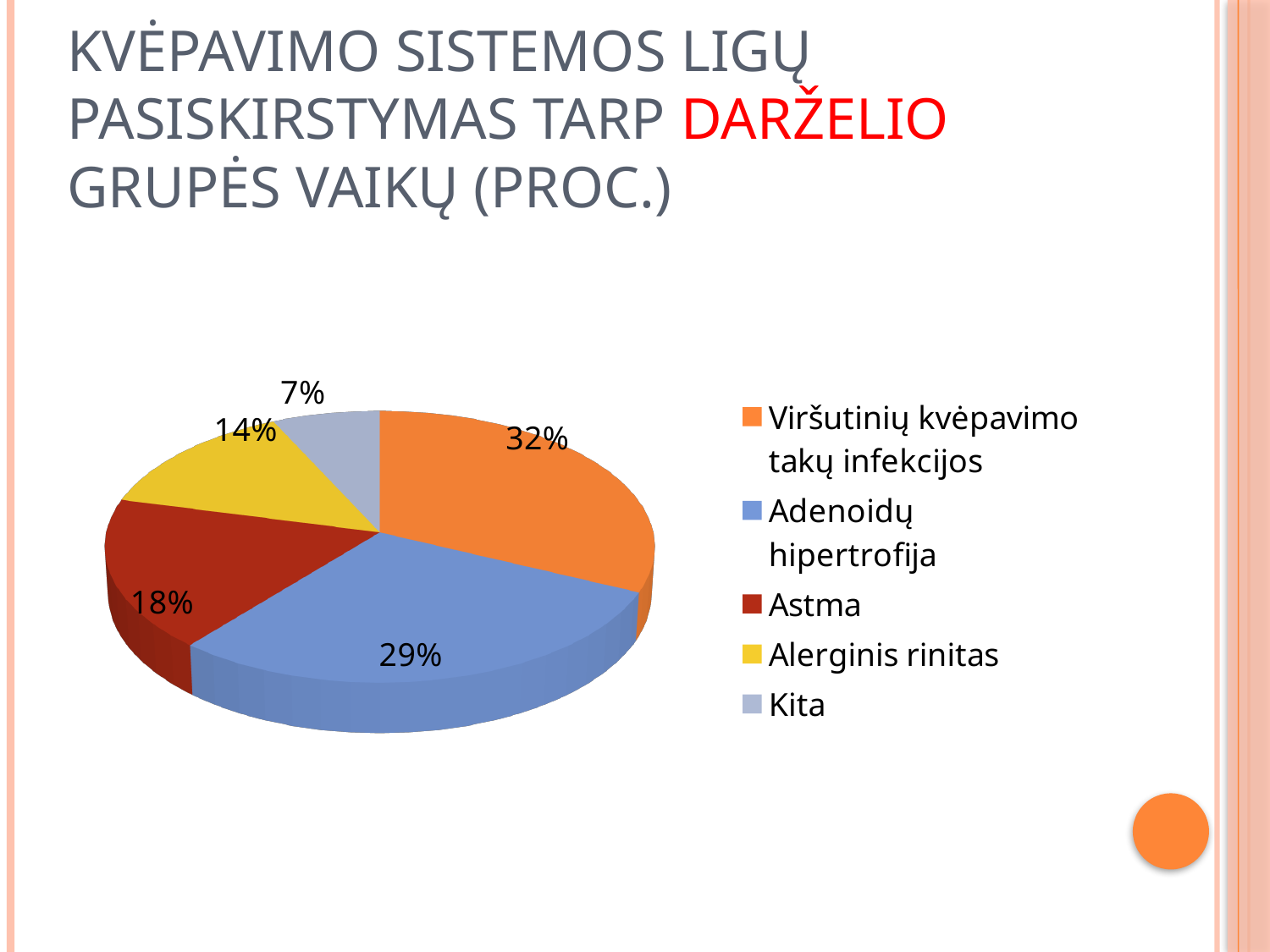
Which category has the smallest share of the pie? Kita What percentage of the pie is Astma? 18% What type of chart is shown on the slide? pie chart Which is larger, the share for Astma or the share for Alerginis rinitas? Astma What colour is the slice for Astma? dark red Which category has the largest share of the pie? Viršutinių kvėpavimo takų infekcijos What percentage of the pie is Kita? 7% How many categories does the pie chart have? 5 What percentage of the pie is Adenoidų hipertrofija? 29% What percentage of the pie is Alerginis rinitas? 14% What percentage of the pie is Viršutinių kvėpavimo takų infekcijos? 32% What is the difference in percentage points between Viršutinių kvėpavimo takų infekcijos and Adenoidų hipertrofija? 3